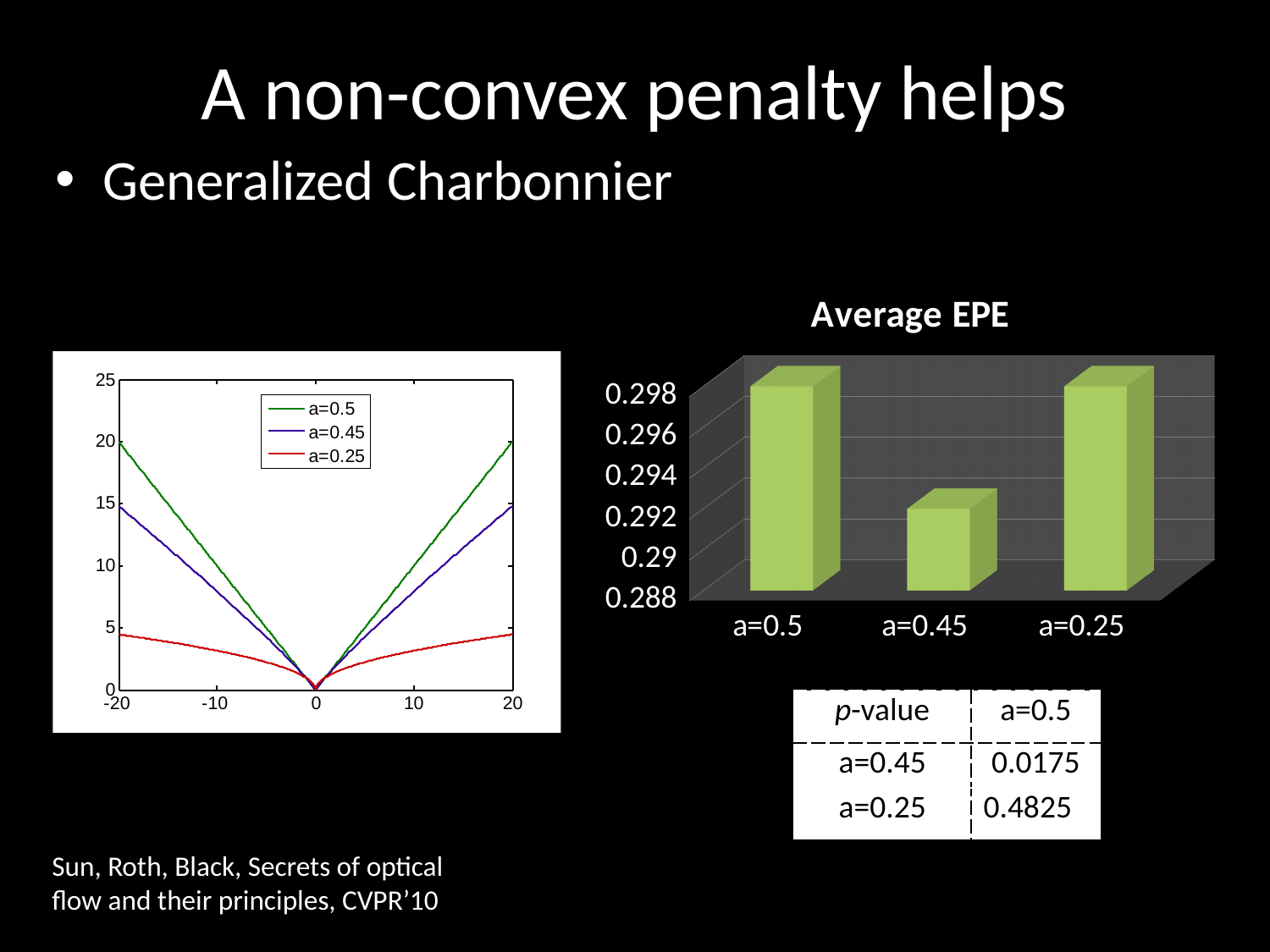
How many categories are shown in the 'Average EPE' bar chart? 3 In the 'Average EPE' bar chart, is the value for a=0.45 greater or less than 0.294? less In the 'Average EPE' bar chart, which category has the lowest value? a=0.45 What colour is the a=0.25 line in the left-hand line chart? red In the 'Average EPE' bar chart, which is larger, the value for a=0.5 or the value for a=0.45? a=0.5 In the left-hand line chart, do the values of the a=0.5 series rise or fall as x goes from 0 to 20? rise In the 'Average EPE' bar chart, is the value for a=0.5 greater or less than 0.296? greater In the left-hand line chart, is the value of the a=0.25 series at x=20 greater or less than 5? less In the left-hand line chart, which series has the lowest value at x=20? a=0.25 What kind of chart is the 'Average EPE' chart on the right? bar chart What kind of chart is the chart on the left of the slide? line chart How many series does the legend of the left-hand line chart list? 3